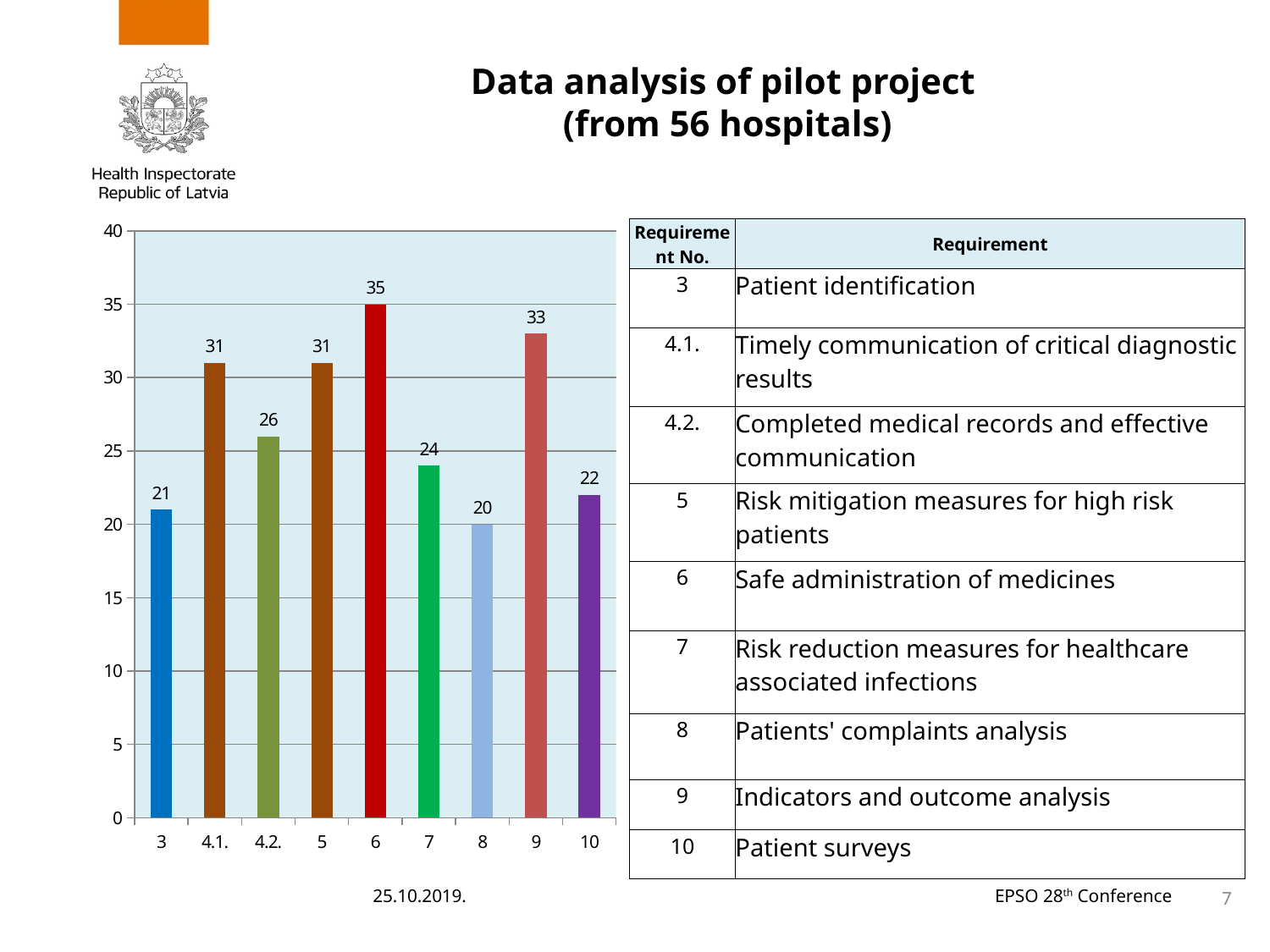
What is the value for requirement 4.2. in the bar chart? 26 How many bars are shown in the bar chart? 9 What is the difference between the values for requirement 6 and requirement 8? 15 Which requirement number has the highest value in the bar chart? 6 What is the difference between the values for requirement 9 and requirement 10? 11 What is the value for requirement 6 in the bar chart? 35 What is the maximum value shown on the vertical axis of the chart? 40 What kind of chart is shown on the slide? bar chart What is the value for requirement 8 in the bar chart? 20 Is the value for requirement 3 greater or less than 25? less Which has a larger value, requirement 7 or requirement 4.2.? 4.2. Which requirement number has the lowest value in the bar chart? 8